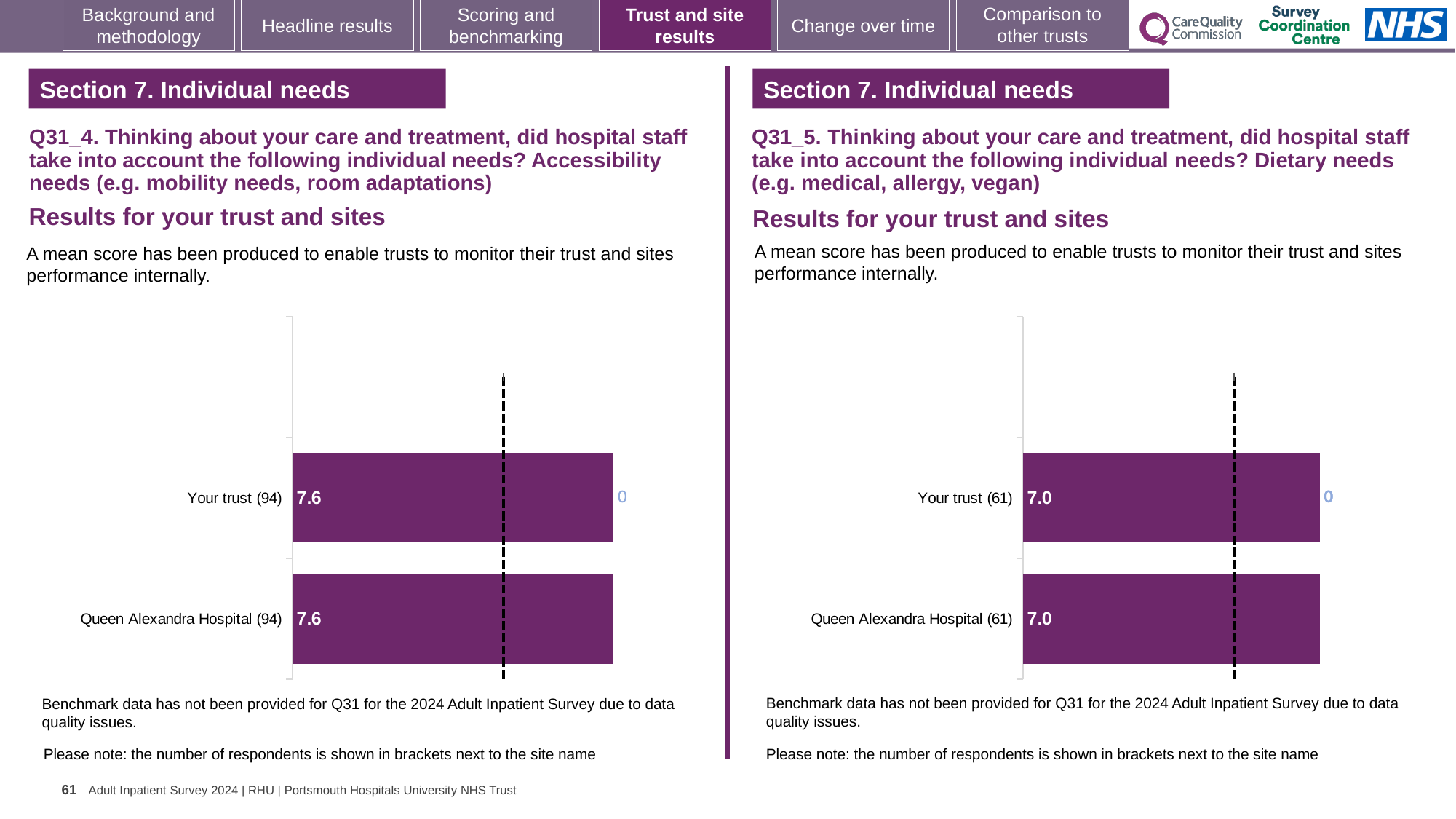
On the left chart (Q31_4, Accessibility needs), what is the mean score for Your trust? 7.6 What kind of chart is used on the right (Q31_5, Dietary needs)? Bar chart How many bars are plotted on the right chart (Q31_5, Dietary needs)? 2 On the right chart (Q31_5, Dietary needs), what is the mean score for Your trust? 7.0 On the left chart (Q31_4, Accessibility needs), how many respondents are shown in brackets next to Your trust? 94 What kind of chart is used on the left (Q31_4, Accessibility needs)? Bar chart What is the difference between the Your trust score on the left chart (Q31_4) and the Your trust score on the right chart (Q31_5)? 0.6 Which is larger: the Your trust score on the left chart (Q31_4) or the Your trust score on the right chart (Q31_5)? Left chart (Q31_4), 7.6 How many bars are plotted on the left chart (Q31_4, Accessibility needs)? 2 On the right chart (Q31_5, Dietary needs), what is the mean score for Queen Alexandra Hospital? 7.0 On the right chart (Q31_5, Dietary needs), how many respondents are shown in brackets next to Queen Alexandra Hospital? 61 On the left chart (Q31_4, Accessibility needs), what is the mean score for Queen Alexandra Hospital? 7.6